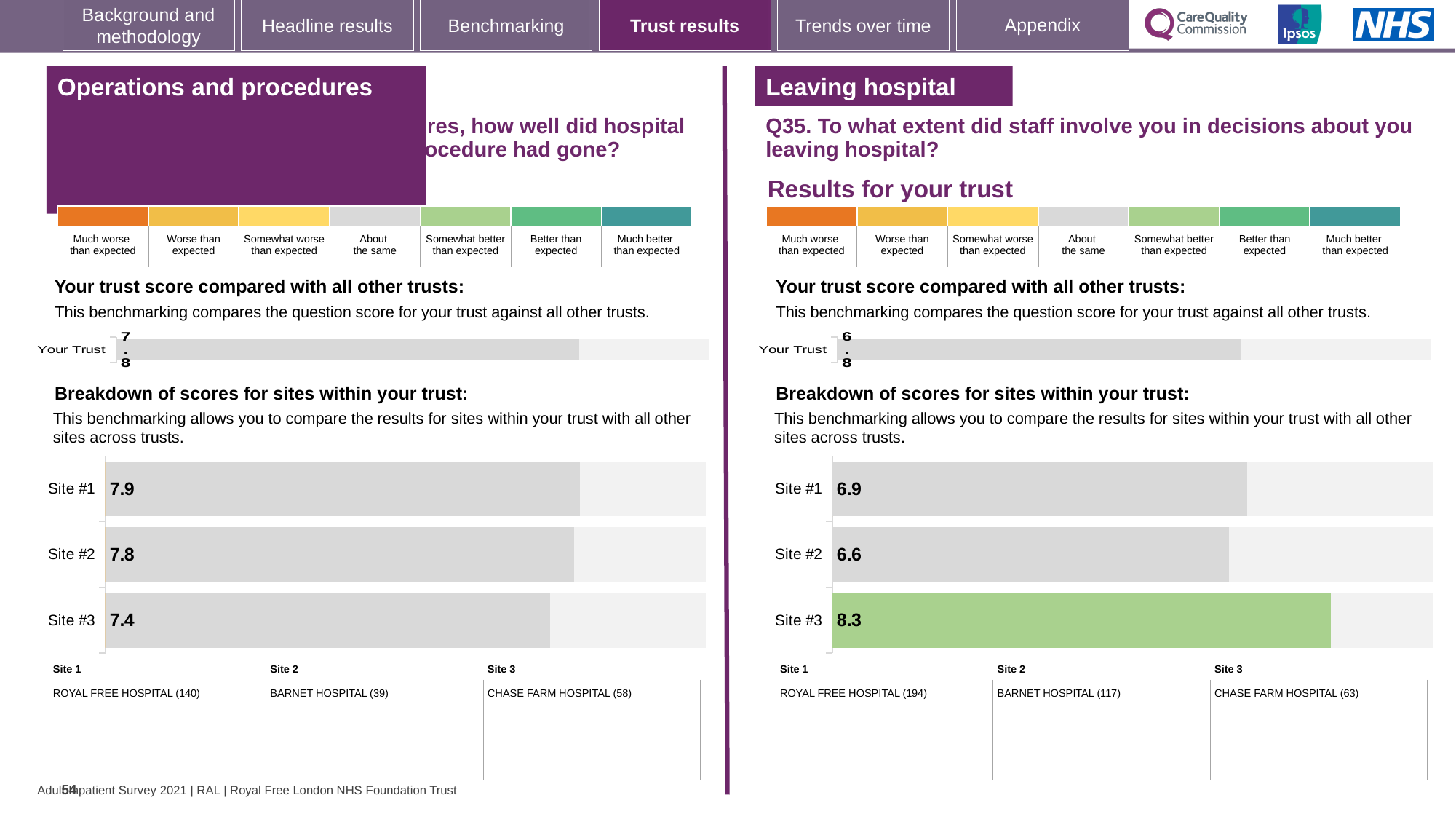
In the 'Your trust score compared with all other trusts' chart under 'Leaving hospital' (right side), what is the score for Your Trust? 6.8 In the 'Breakdown of scores for sites within your trust' chart under 'Operations and procedures' (left side), what is the score for Site #1? 7.9 In the site breakdown chart under 'Operations and procedures' (left side), what is the difference between the scores for Site #1 and Site #3? 0.5 In the site breakdown chart under 'Leaving hospital' (right side), what is the difference between the scores for Site #3 and Site #2? 1.7 In the site breakdown chart under 'Operations and procedures' (left side), which site has the lowest score? Site #3 What kind of chart is the site breakdown chart under 'Leaving hospital' (right side)? Bar chart In the 'Breakdown of scores for sites within your trust' chart under 'Leaving hospital' (right side), what is the score for Site #3? 8.3 How many sites are shown in the site breakdown chart under 'Operations and procedures' (left side)? 3 In the site breakdown chart under 'Leaving hospital' (right side), which site has the highest score? Site #3 In the site breakdown chart under 'Leaving hospital' (right side), which site's bar is coloured green rather than grey? Site #3 In the site breakdown chart under 'Leaving hospital' (right side), which has the larger score, Site #1 or Site #2? Site #1 In the 'Your trust score compared with all other trusts' chart under 'Operations and procedures' (left side), what is the score for Your Trust? 7.8